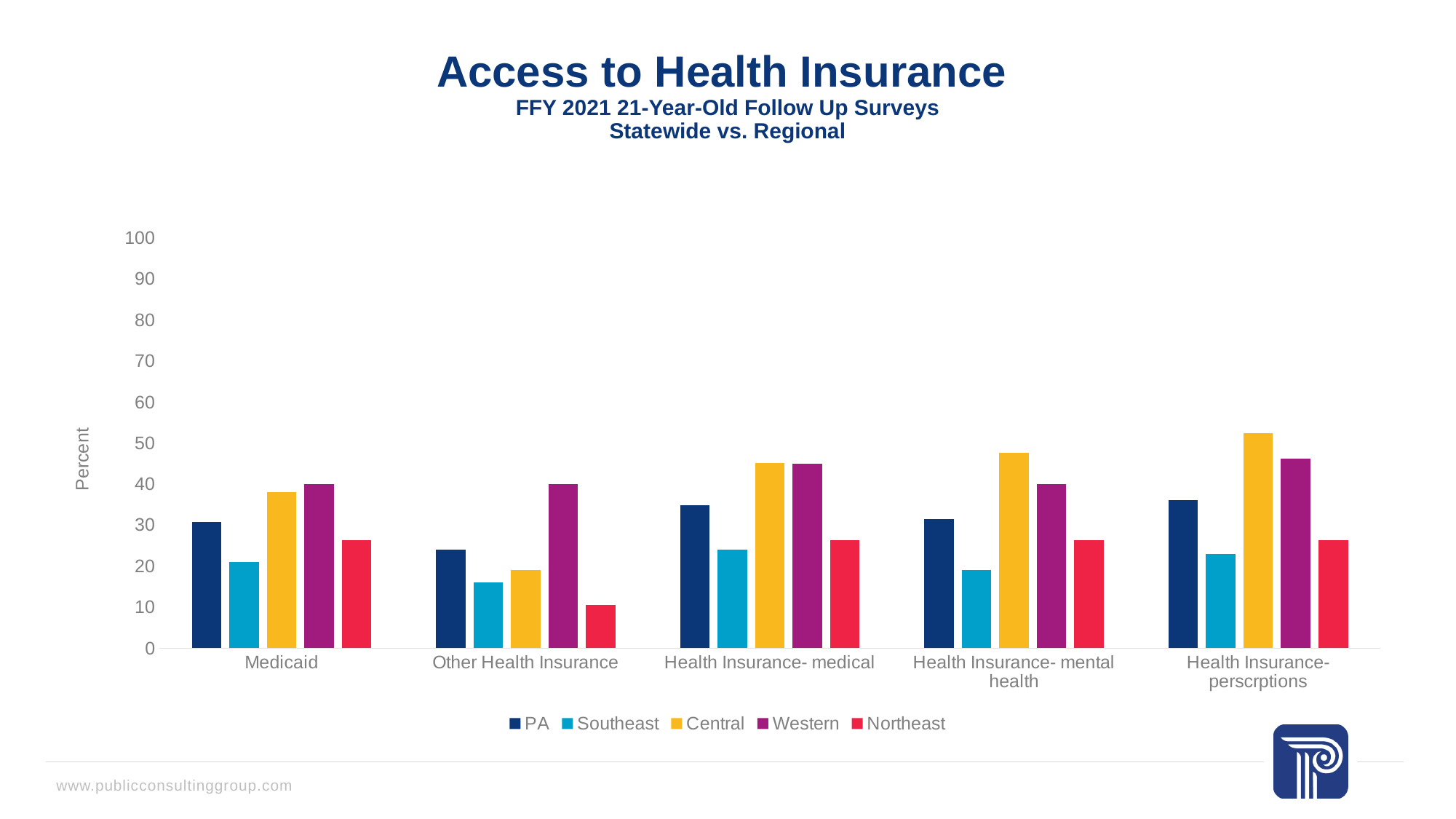
Which series has the lowest value for Other Health Insurance? Northeast Is the Central value for Health Insurance- perscrptions greater or less than 50? greater Which series has the highest value for Other Health Insurance? Western Which series has the lowest value for Health Insurance- mental health? Southeast What kind of chart is shown on the slide? bar chart How many categories are shown along the x axis? 5 Which series has the highest value for Health Insurance- perscrptions? Central What is the label on the y axis? Percent For Medicaid, which is larger: the PA value or the Southeast value? PA What is the main title of the chart? Access to Health Insurance How many series does the legend list? 5 Is the Northeast value for Other Health Insurance greater or less than 20? less